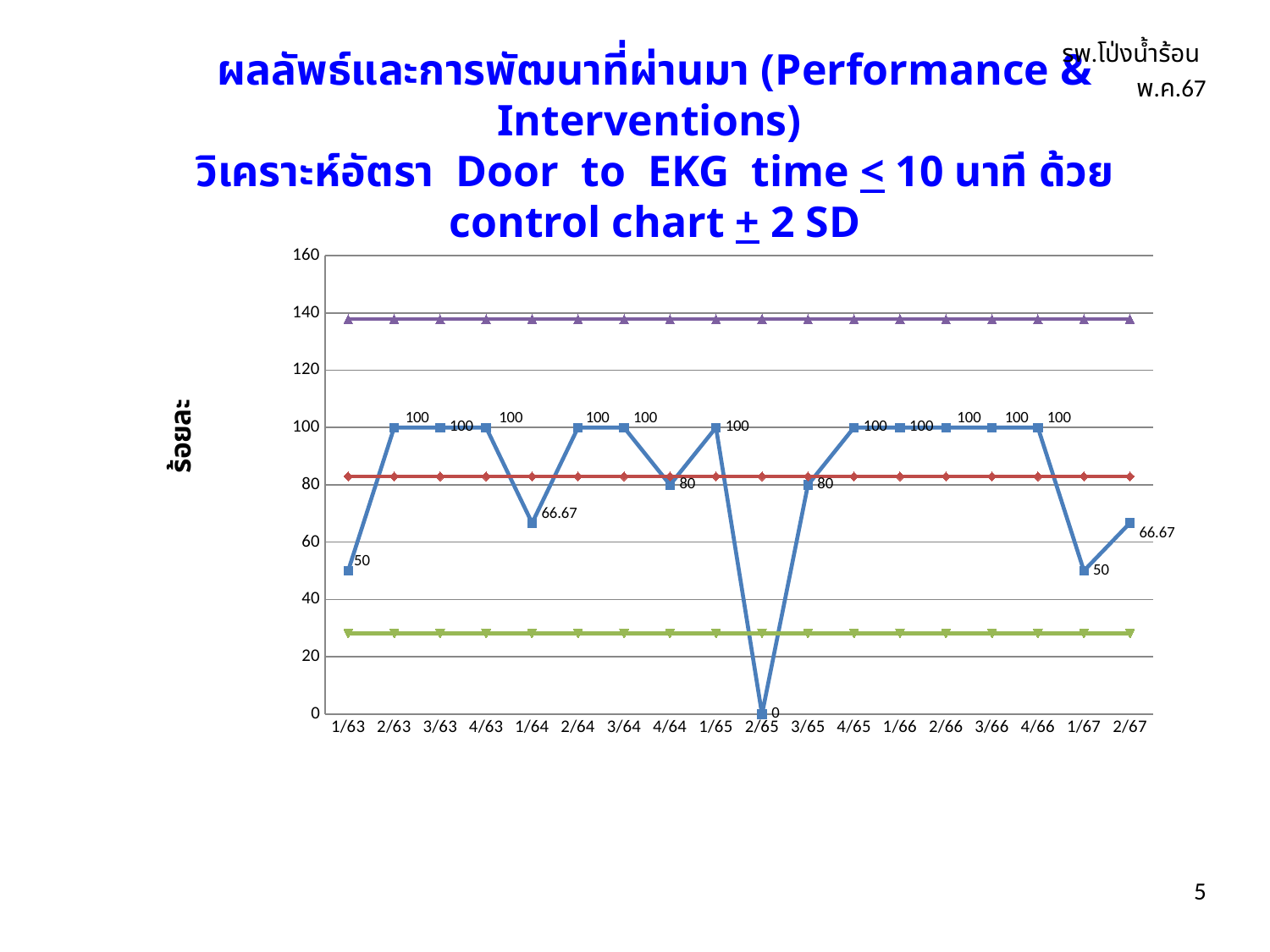
What is the value for 2/65? 0 What is the difference between the values for 4/64 and 1/67? 30 What is the value for 1/63? 50 What is the value for 1/64? 66.67 What is the value for 3/65? 80 What is the label on the y axis? ร้อยละ What is the value for 2/67? 66.67 How many time periods are plotted along the x axis? 18 Is the upper control limit line greater or less than 120? greater What kind of chart is shown on the slide? line chart Which is larger, the value for 1/64 or the value for 4/64? 4/64 Which period has the lowest value on the data line? 2/65